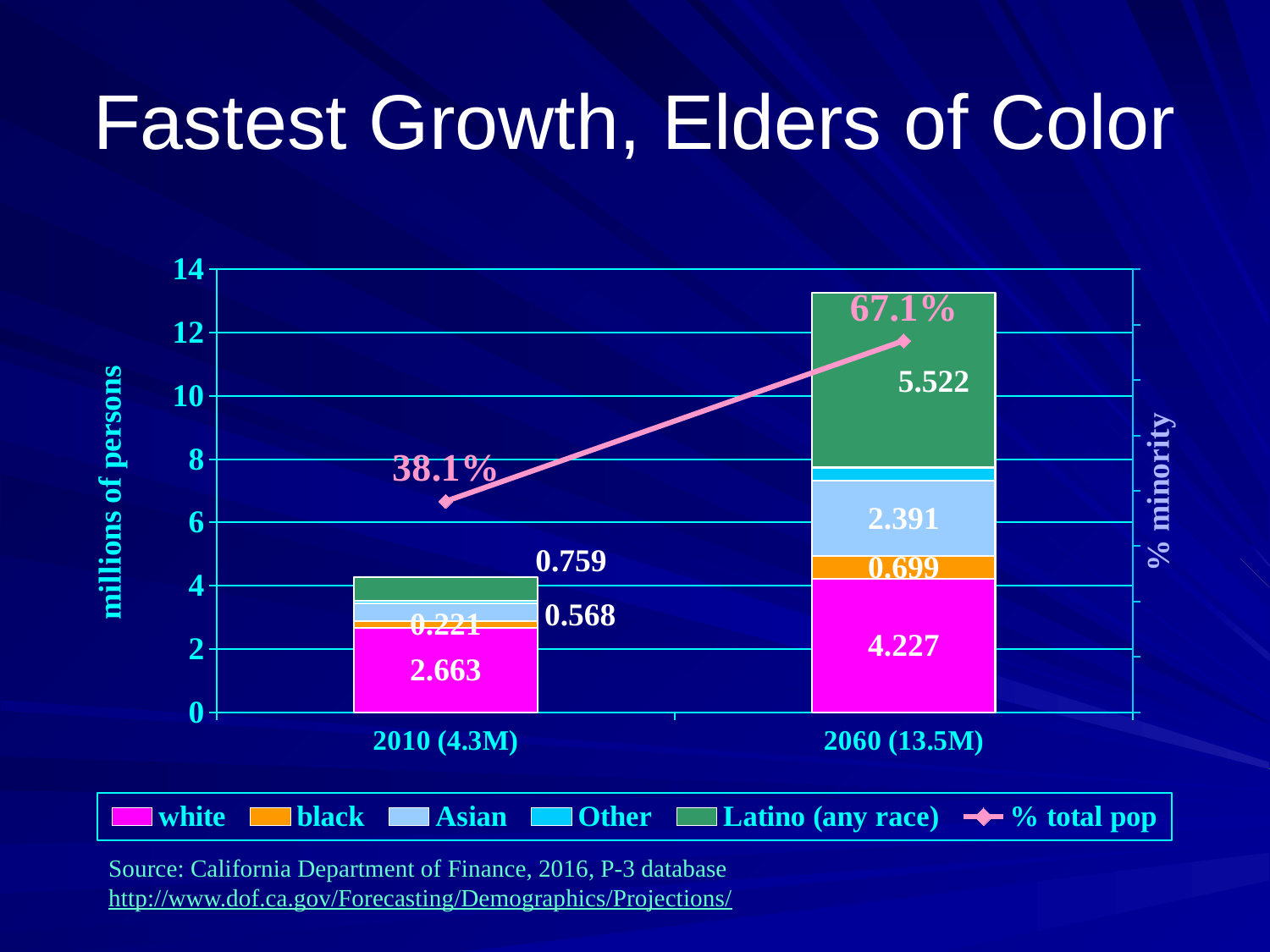
How many series does the legend list? 6 What is the value for Latino (any race) in 2060 (13.5M)? 5.522 Is the total height of the 2060 (13.5M) bar greater or less than 12? greater Does the % total pop line rise or fall from 2010 to 2060? rise What is the % total pop value shown for 2010 (4.3M)? 38.1% What is the value for black in 2060 (13.5M)? 0.699 Is the white value larger in 2010 (4.3M) or 2060 (13.5M)? 2060 (13.5M) What is the difference between the white values for 2060 (13.5M) and 2010 (4.3M)? 1.564 Which segment is largest in the 2060 (13.5M) bar? Latino (any race) What is the value for Asian in 2060 (13.5M)? 2.391 What is the % total pop value shown for 2060 (13.5M)? 67.1% What is the value for white in 2010 (4.3M)? 2.663